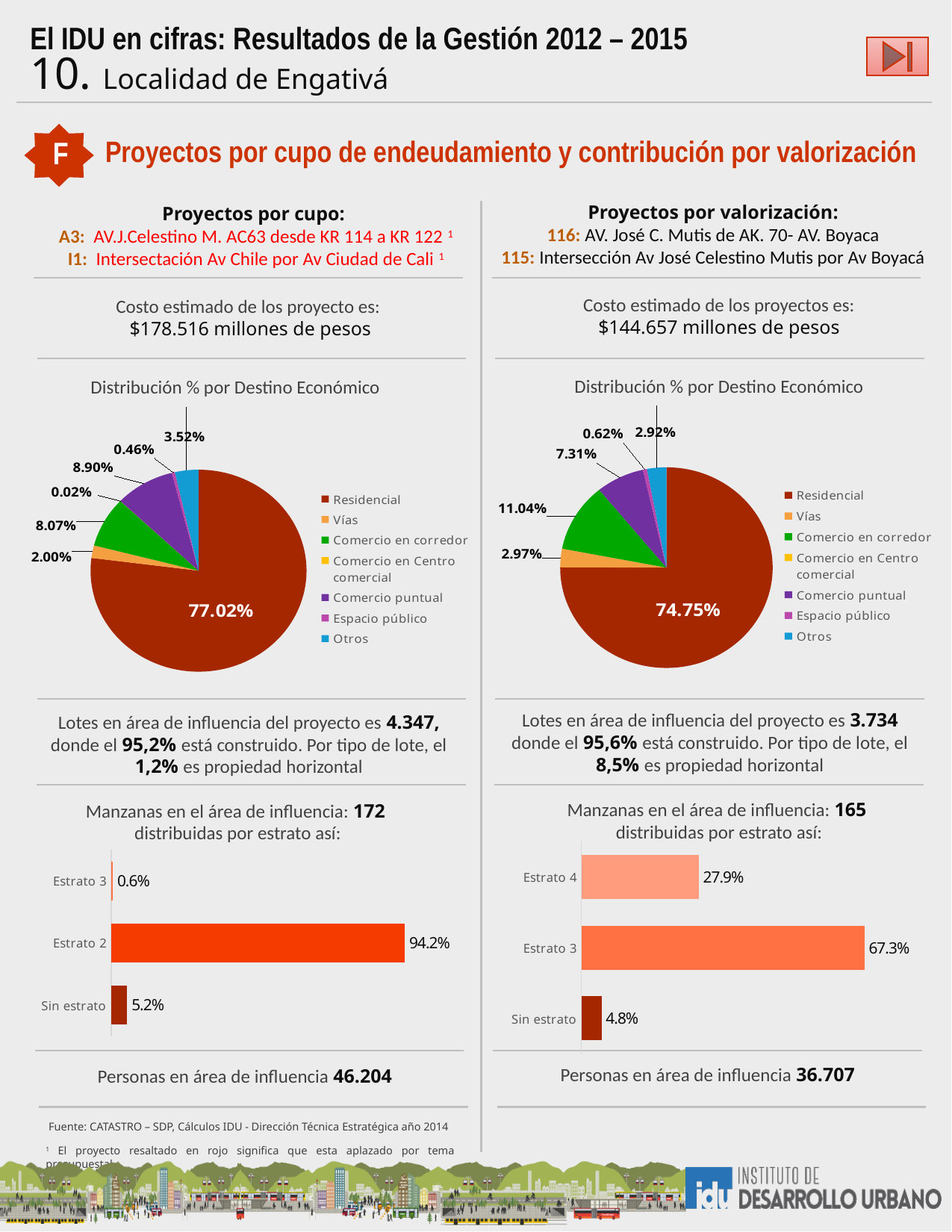
In the right bar chart (Manzanas en el área de influencia, Proyectos por valorización), what is the value for Estrato 4? 27.9% In the right bar chart (Manzanas en el área de influencia, Proyectos por valorización), what is the difference between Estrato 3 and Estrato 4? 39.4% In the right pie chart (Proyectos por valorización), what is the value for Comercio en corredor? 11.04% In the left pie chart (Proyectos por cupo), which category has the smallest share? Comercio en Centro comercial In the right pie chart (Proyectos por valorización, Distribución % por Destino Económico), what share does Residencial have? 74.75% In the left pie chart (Proyectos por cupo, Distribución % por Destino Económico), what share does Residencial have? 77.02% In the left pie chart (Proyectos por cupo), what is the value for Comercio puntual? 8.90% In the left bar chart (Manzanas en el área de influencia, Proyectos por cupo), what is the value for Estrato 2? 94.2% What type of chart is used to show the Manzanas en el área de influencia distribution by estrato on the left side? Bar chart How many entries does the legend of the right pie chart (Proyectos por valorización) list? 7 In the left bar chart (Manzanas en el área de influencia, Proyectos por cupo), which is larger: Sin estrato or Estrato 3? Sin estrato In the right bar chart (Manzanas en el área de influencia, Proyectos por valorización), which category has the highest value? Estrato 3